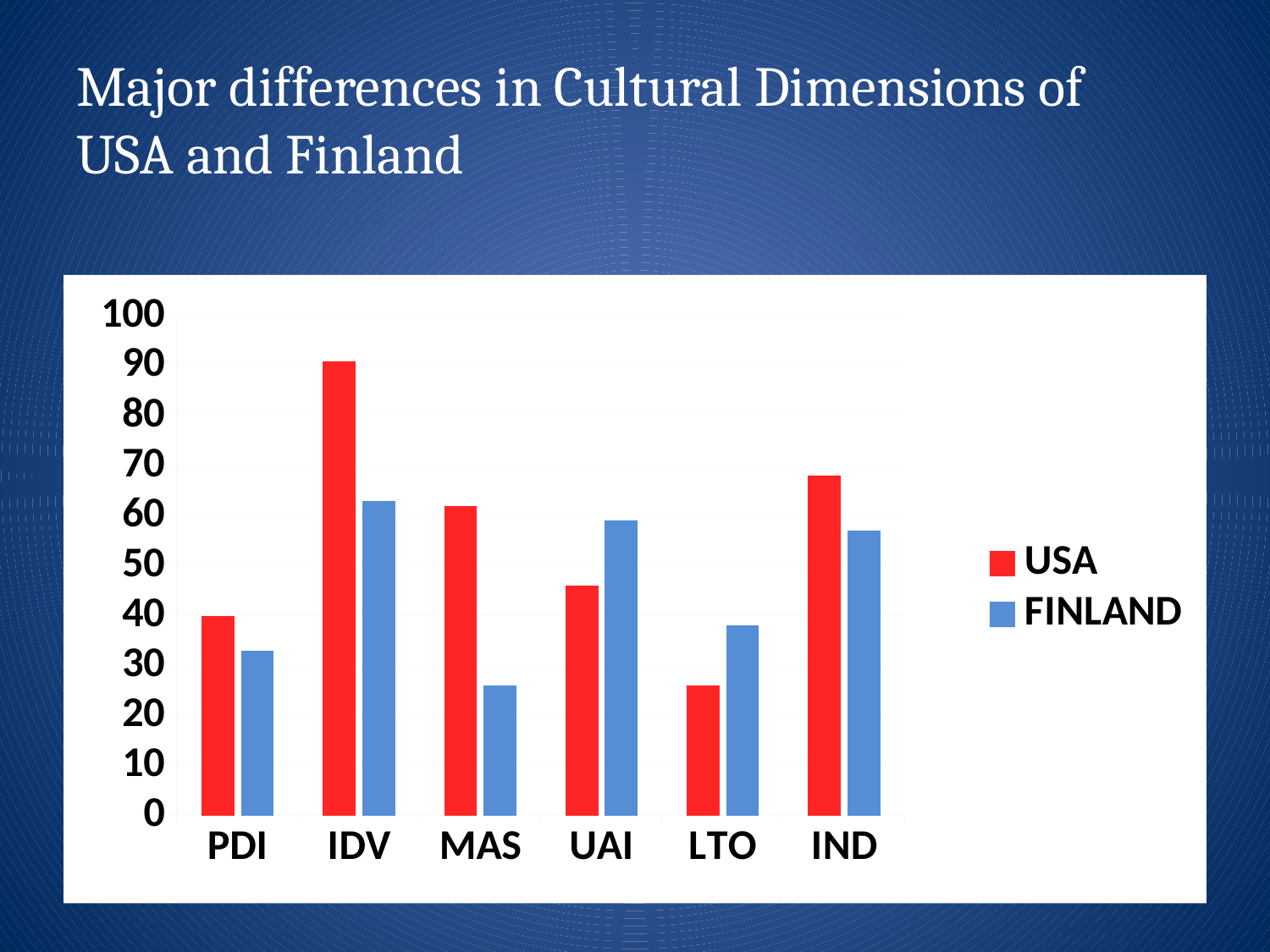
Is the FINLAND value for MAS greater or less than 30? less How many categories are shown on the x axis? 6 What kind of chart is shown on the slide? bar chart Which category has the lowest USA value? LTO How many series does the legend list? 2 Which category has the highest USA value? IDV Is the USA value for IDV greater or less than 80? greater Which category has the highest FINLAND value? IDV For MAS, which is larger, the USA value or the FINLAND value? USA For UAI, which is larger, the USA value or the FINLAND value? FINLAND Which category has the lowest FINLAND value? MAS Which colour represents FINLAND in the chart? blue